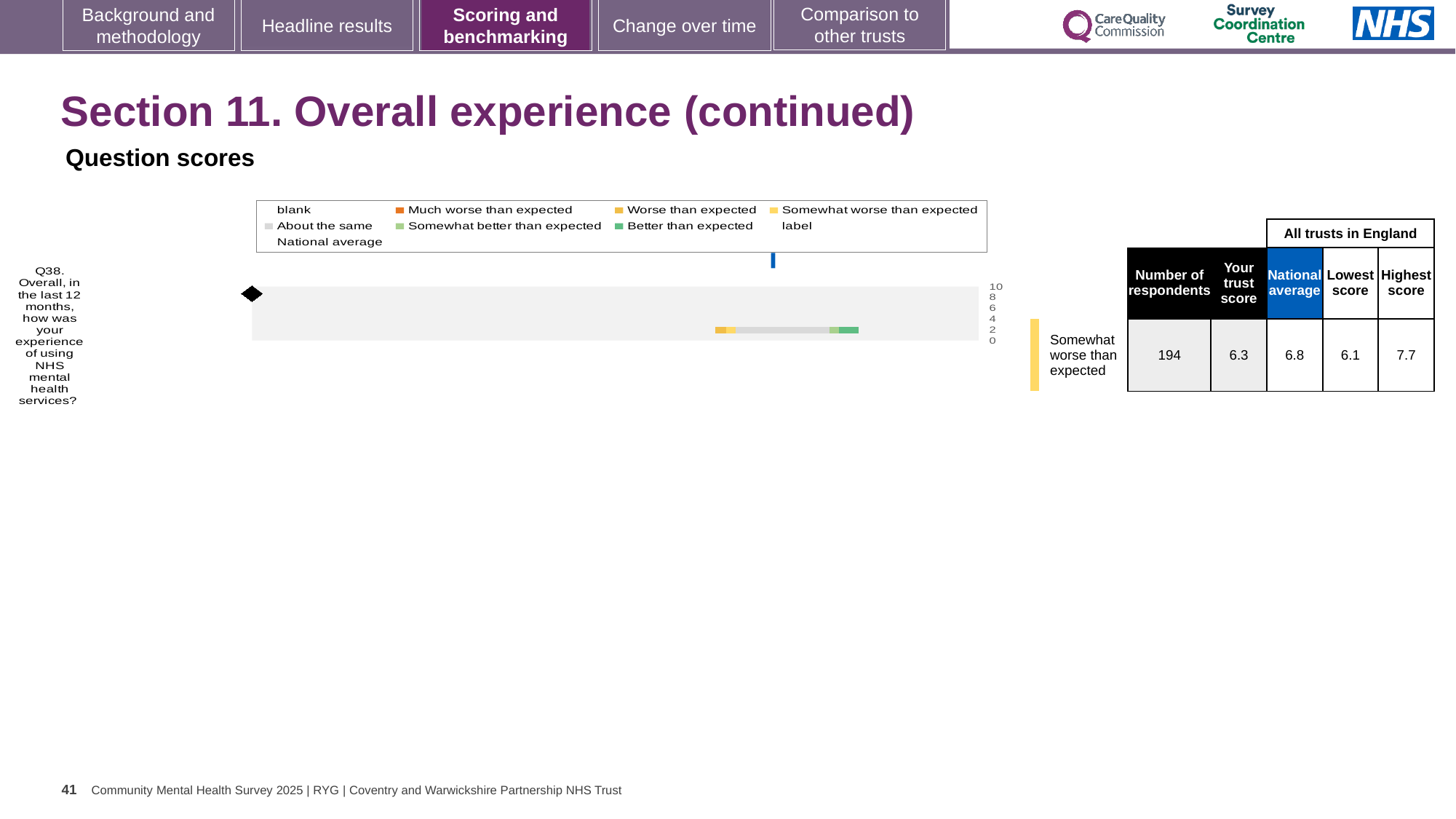
What is the difference between the national average and the trust's score for Q38? 0.5 How many questions are plotted on the chart? 1 What is the national average score for Q38? 6.8 What is the highest score among all trusts in England for Q38? 7.7 Which is larger for Q38: the trust's score or the national average? national average What is the lowest score among all trusts in England for Q38? 6.1 Which benchmark category is Q38 placed in, according to the label next to the chart? Somewhat worse than expected What kind of chart is used to show the question score for Q38? bar chart What is the trust's score for Q38? 6.3 What is the highest value shown on the chart's score axis? 10 What is the difference between the highest and lowest scores among all trusts in England for Q38? 1.6 How many respondents answered Q38? 194